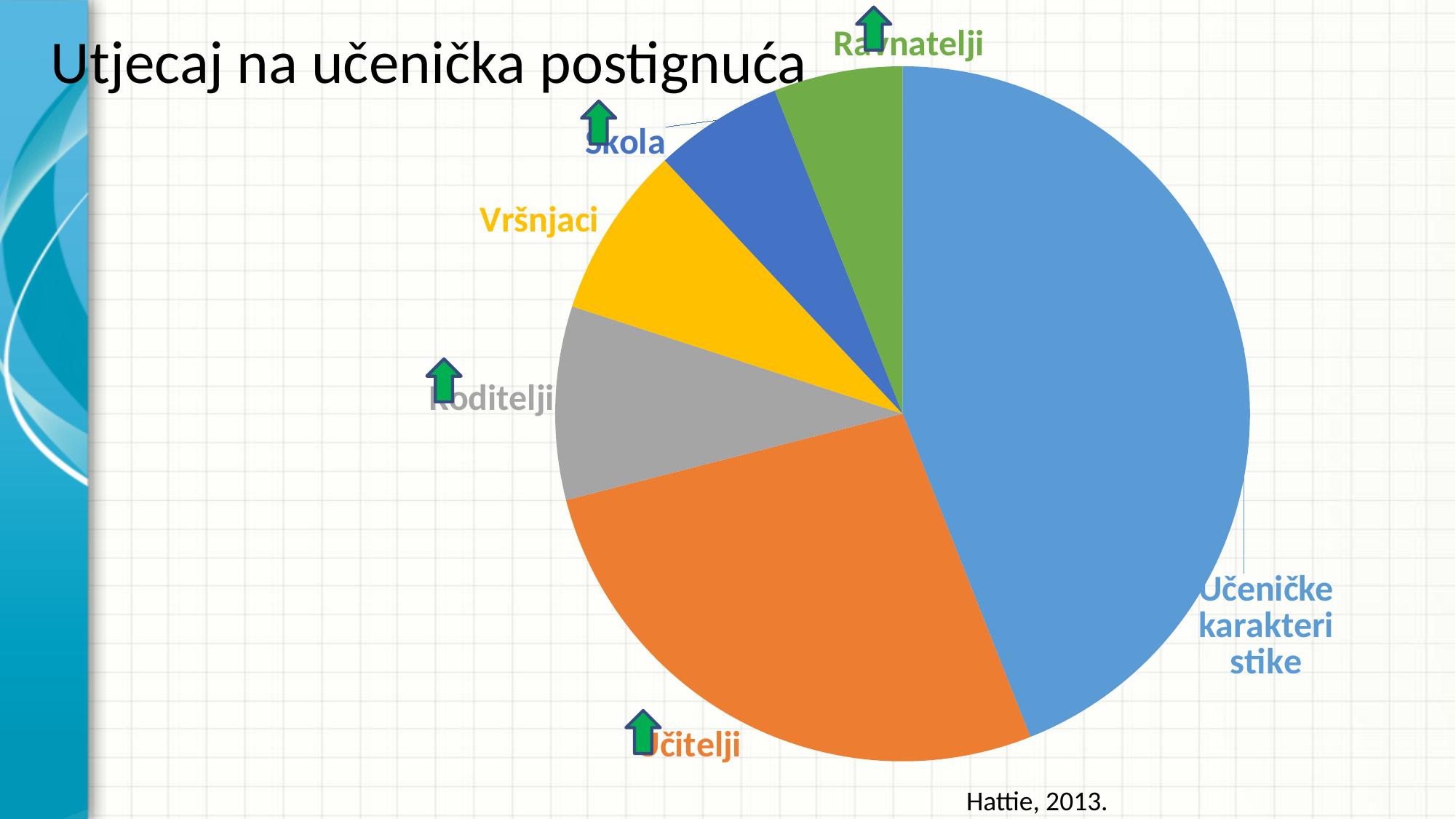
Which slice is larger, Učeničke karakteristike or Učitelji? Učeničke karakteristike What kind of chart is shown on the slide? pie chart What is the title of the slide containing the pie chart? Utjecaj na učenička postignuća Which slice is larger, Učitelji or Vršnjaci? Učitelji What colour is the Učitelji slice of the pie chart? orange Which category has the second-largest slice of the pie chart? Učitelji How many slices does the pie chart have? 6 Which slice is larger, Učitelji or Roditelji? Učitelji Which category has the largest slice of the pie chart? Učeničke karakteristike